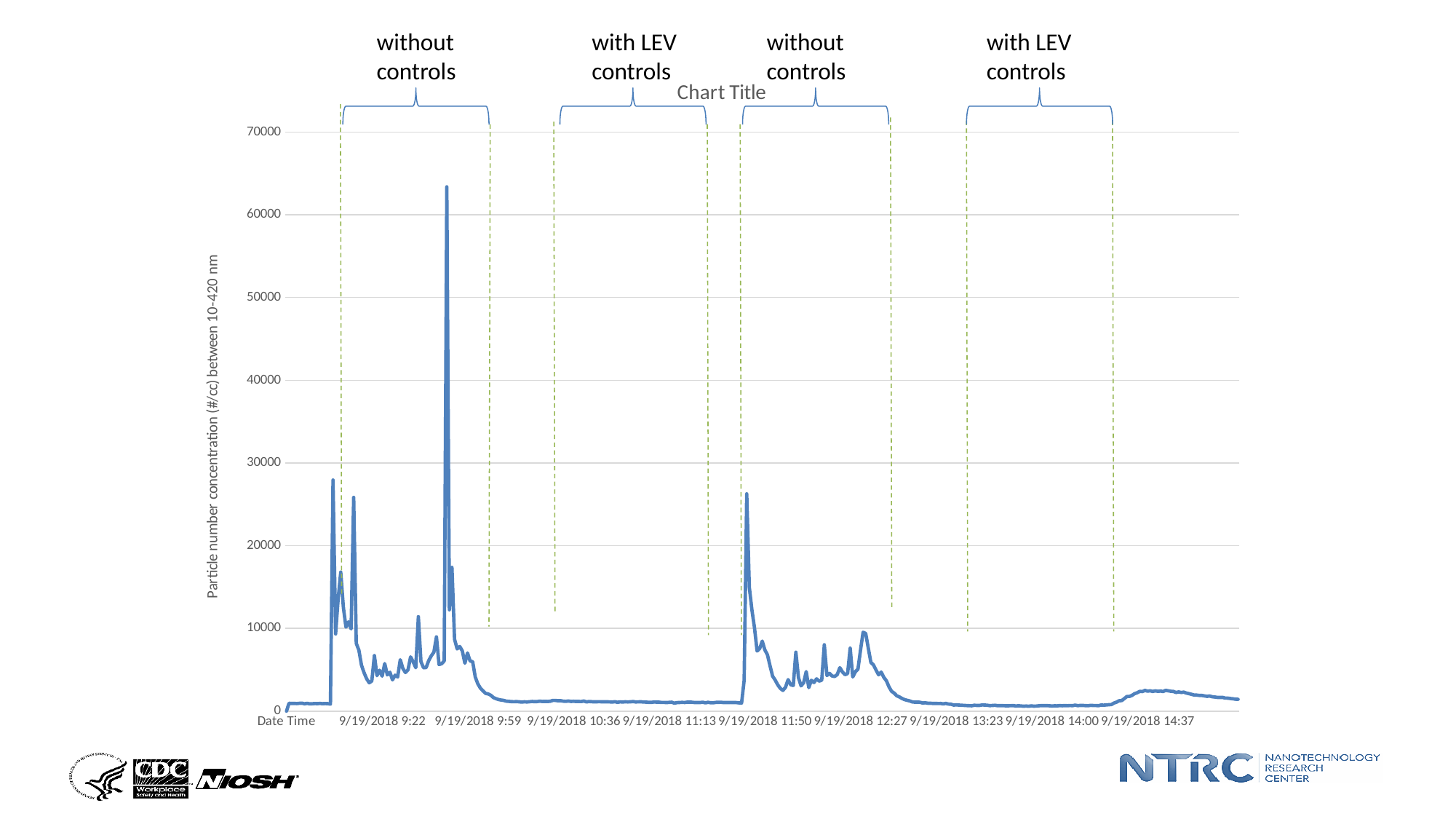
During the 'with LEV controls' periods, is the line greater or less than 10000? less Which annotated period contains the highest peak of the line? the first 'without controls' period Does the line rise or fall after the large spike near 9/19/2018 9:59? fall How many periods are labelled 'with LEV controls'? 2 What kind of chart is shown on the slide? line chart Is the peak in the first 'without controls' period higher or lower than the peak in the second 'without controls' period? higher What is the label of the vertical axis? Particle number concentration (#/cc) between 10-420 nm What is the highest value shown on the vertical axis? 70000 Is the highest peak of the line greater or less than 60000? greater How many annotated periods are marked with brackets above the chart? 4 Is the highest peak in the second 'without controls' period greater or less than 30000? less What is the title shown above the chart? Chart Title